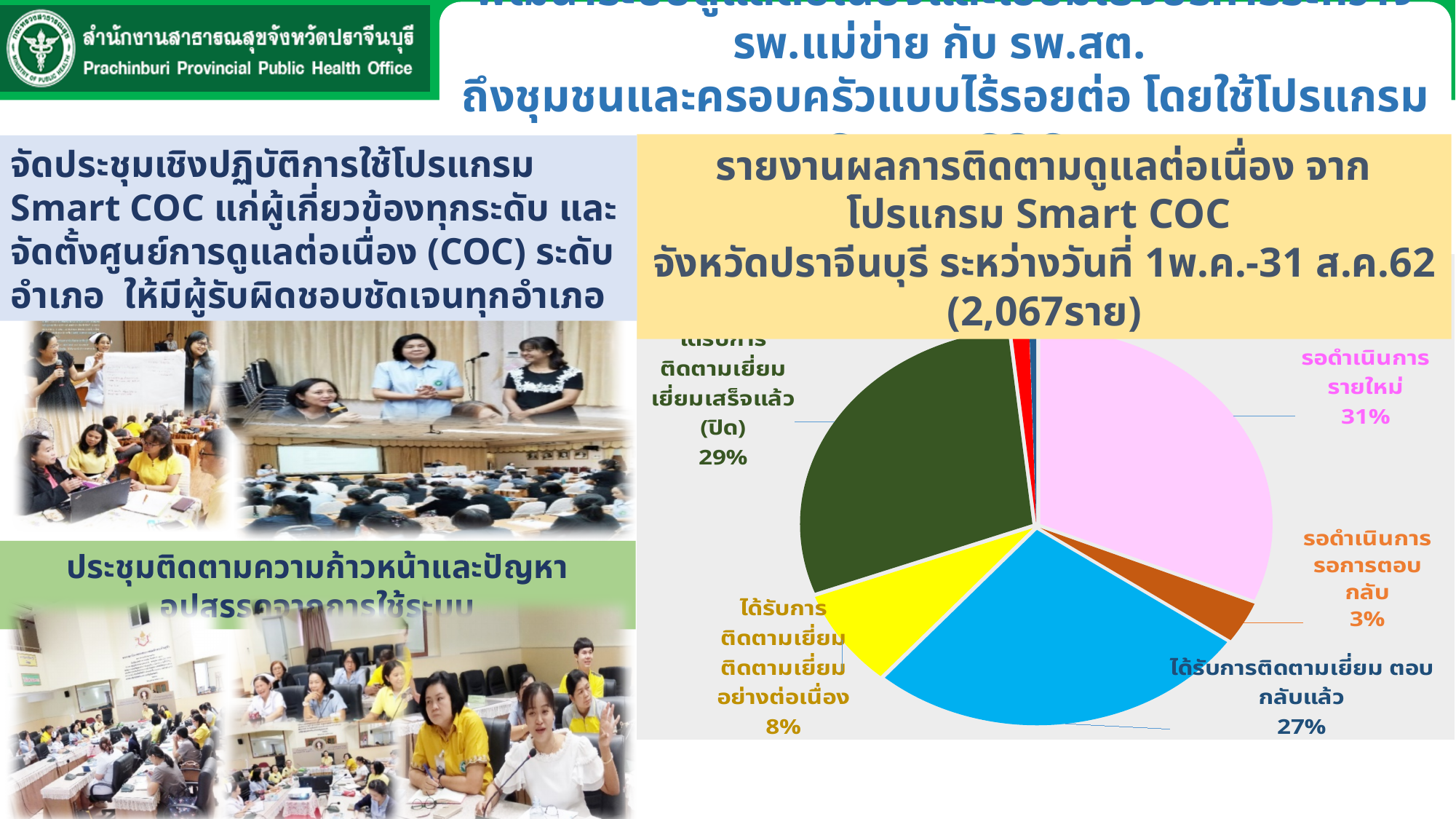
Which labelled slice of the pie chart has the largest share? รอดำเนินการ รายใหม่ How many slices of the pie chart have a percentage label printed? 5 Which labelled slice of the pie chart has the smallest share? รอดำเนินการ รอการตอบกลับ What percentage of the pie chart is labelled ได้รับการติดตามเยี่ยม ติดตามเยี่ยมอย่างต่อเนื่อง? 8% According to the chart title, how many cases (ราย) does the pie chart cover? 2,067 What percentage of the pie chart is labelled ได้รับการติดตามเยี่ยม เยี่ยมเสร็จแล้ว (ปิด)? 29% What percentage of the pie chart is labelled ได้รับการติดตามเยี่ยม ตอบกลับแล้ว? 27% What percentage of the pie chart is labelled รอดำเนินการ รอการตอบกลับ? 3% Which is larger in the pie chart: the ได้รับการติดตามเยี่ยม เยี่ยมเสร็จแล้ว (ปิด) slice or the ได้รับการติดตามเยี่ยม ติดตามเยี่ยมอย่างต่อเนื่อง slice? ได้รับการติดตามเยี่ยม เยี่ยมเสร็จแล้ว (ปิด) What percentage of the pie chart is labelled รอดำเนินการ รายใหม่? 31% What kind of chart is shown on the right side of the slide? pie chart What is the difference in percentage points between the รอดำเนินการ รายใหม่ slice and the ได้รับการติดตามเยี่ยม ตอบกลับแล้ว slice? 4